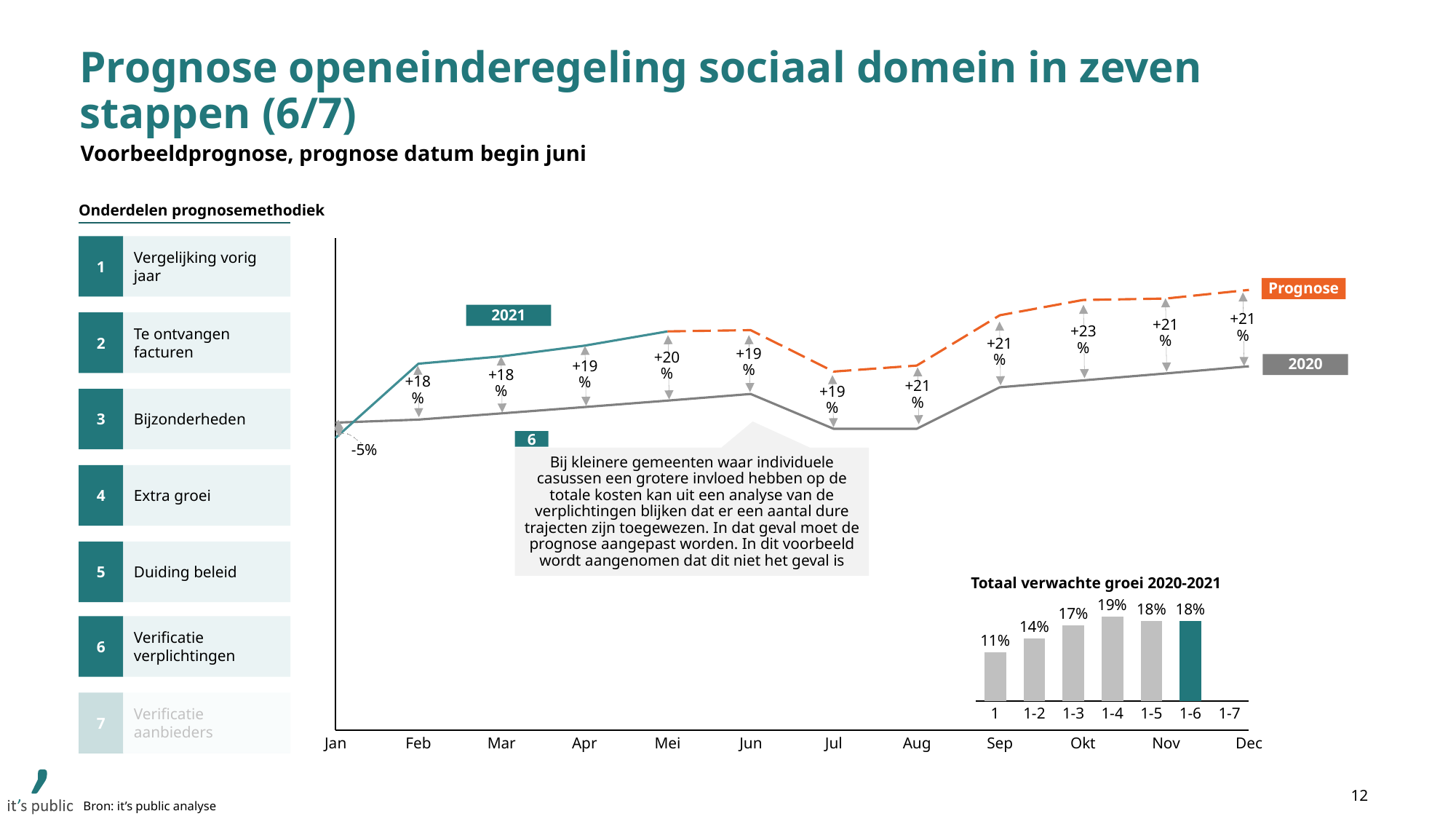
In the bar chart 'Totaal verwachte groei 2020-2021', how many bars have a value shown? 6 In the bar chart 'Totaal verwachte groei 2020-2021', what is the difference between the values for 1-4 and 1? 8 percentage points In the large line chart, which month has the largest labelled percentage difference? Okt What kind of chart is 'Totaal verwachte groei 2020-2021'? Bar chart In the bar chart 'Totaal verwachte groei 2020-2021', which category has the lowest value? 1 In the bar chart 'Totaal verwachte groei 2020-2021', what is the value for category 1-3? 17% In the bar chart 'Totaal verwachte groei 2020-2021', which is larger: the value for 1-2 or the value for 1-5? 1-5 How many months are shown on the x axis of the large line chart? 12 In the large line chart, what percentage difference is labelled for Jan? -5% In the bar chart 'Totaal verwachte groei 2020-2021', which category has the highest value? 1-4 In the large line chart, what percentage difference is labelled for Okt? +23% In the bar chart 'Totaal verwachte groei 2020-2021', which category's bar is coloured teal instead of grey? 1-6